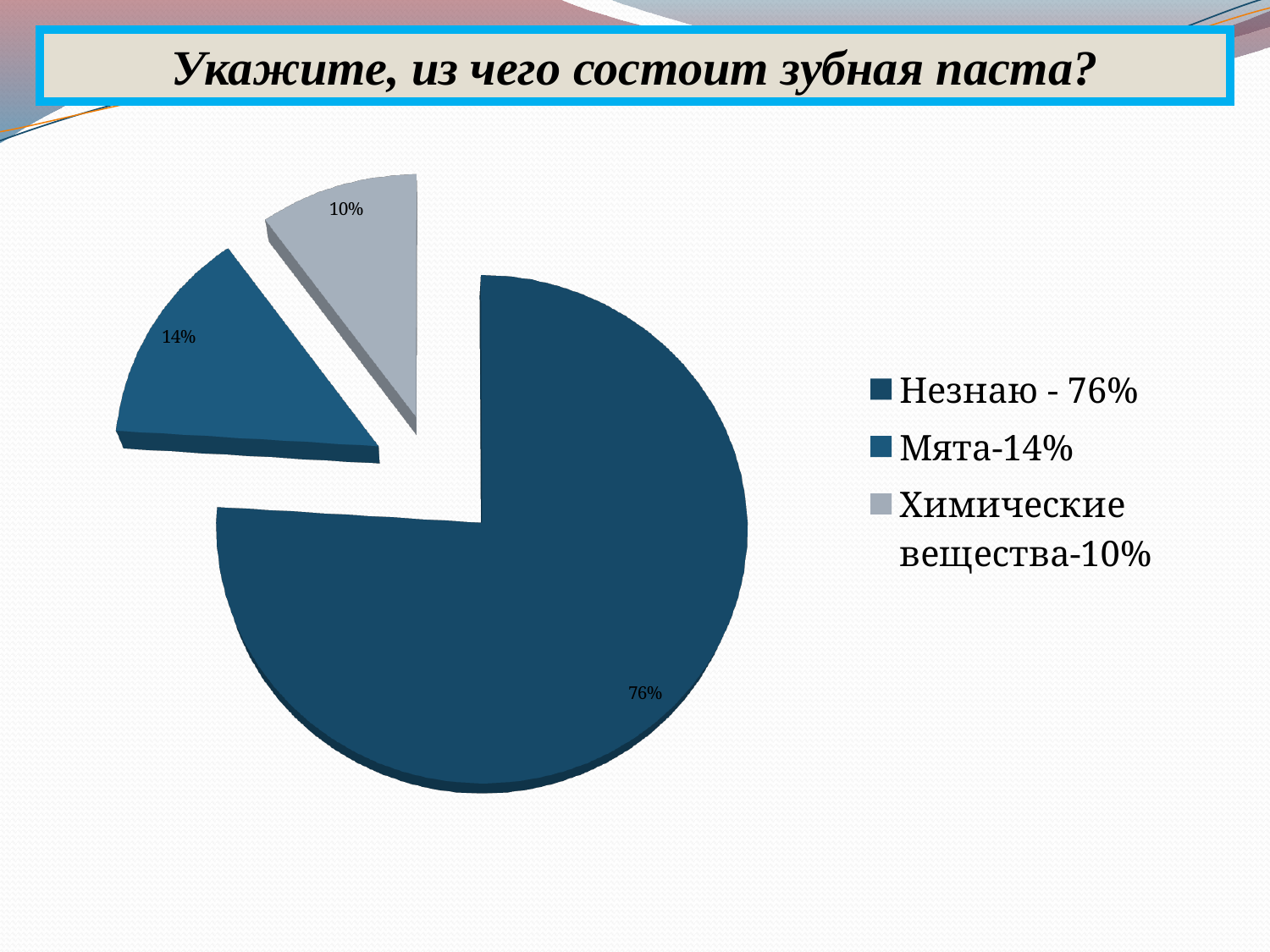
What share of the pie does "Незнаю" take? 76% What share of the pie does "Химические вещества" take? 10% What share of the pie does "Мята" take? 14% Which category has the largest slice of the pie? Незнаю How many slices does the pie chart have? 3 How many entries does the legend list? 3 What is the title of the slide above the chart? Укажите, из чего состоит зубная паста? Which is larger: the slice for "Мята" or the slice for "Химические вещества"? Мята What kind of chart is shown on the slide? pie chart What is the difference in percentage points between "Мята" and "Химические вещества"? 4 What is the difference in percentage points between "Незнаю" and "Мята"? 62 Which category has the smallest slice of the pie? Химические вещества